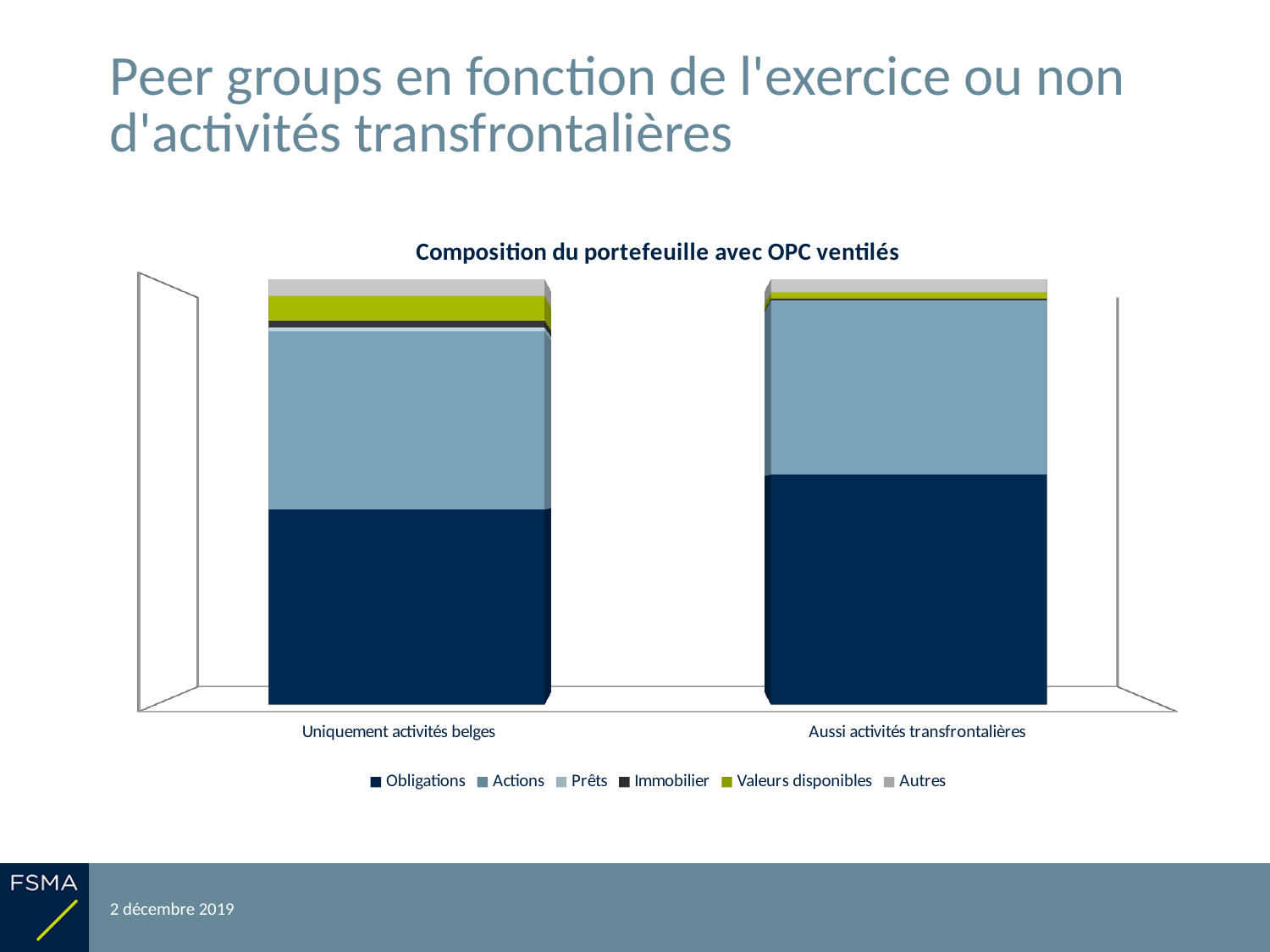
What is the label of the left-hand bar on the x axis? Uniquement activités belges How many series does the legend list? 6 In the bar for 'Uniquement activités belges', which is larger: the Obligations segment or the Actions segment? Obligations Which series is listed first in the legend? Obligations Which series makes up the largest part of the bar for 'Aussi activités transfrontalières'? Obligations Which series makes up the largest part of the bar for 'Uniquement activités belges'? Obligations In the bar for 'Aussi activités transfrontalières', which is larger: the Actions segment or the Valeurs disponibles segment? Actions Is the Valeurs disponibles segment larger for 'Uniquement activités belges' or for 'Aussi activités transfrontalières'? Uniquement activités belges What is the title of the chart? Composition du portefeuille avec OPC ventilés How many categories (bars) are shown on the x axis? 2 What kind of chart is shown on the slide? Stacked bar chart